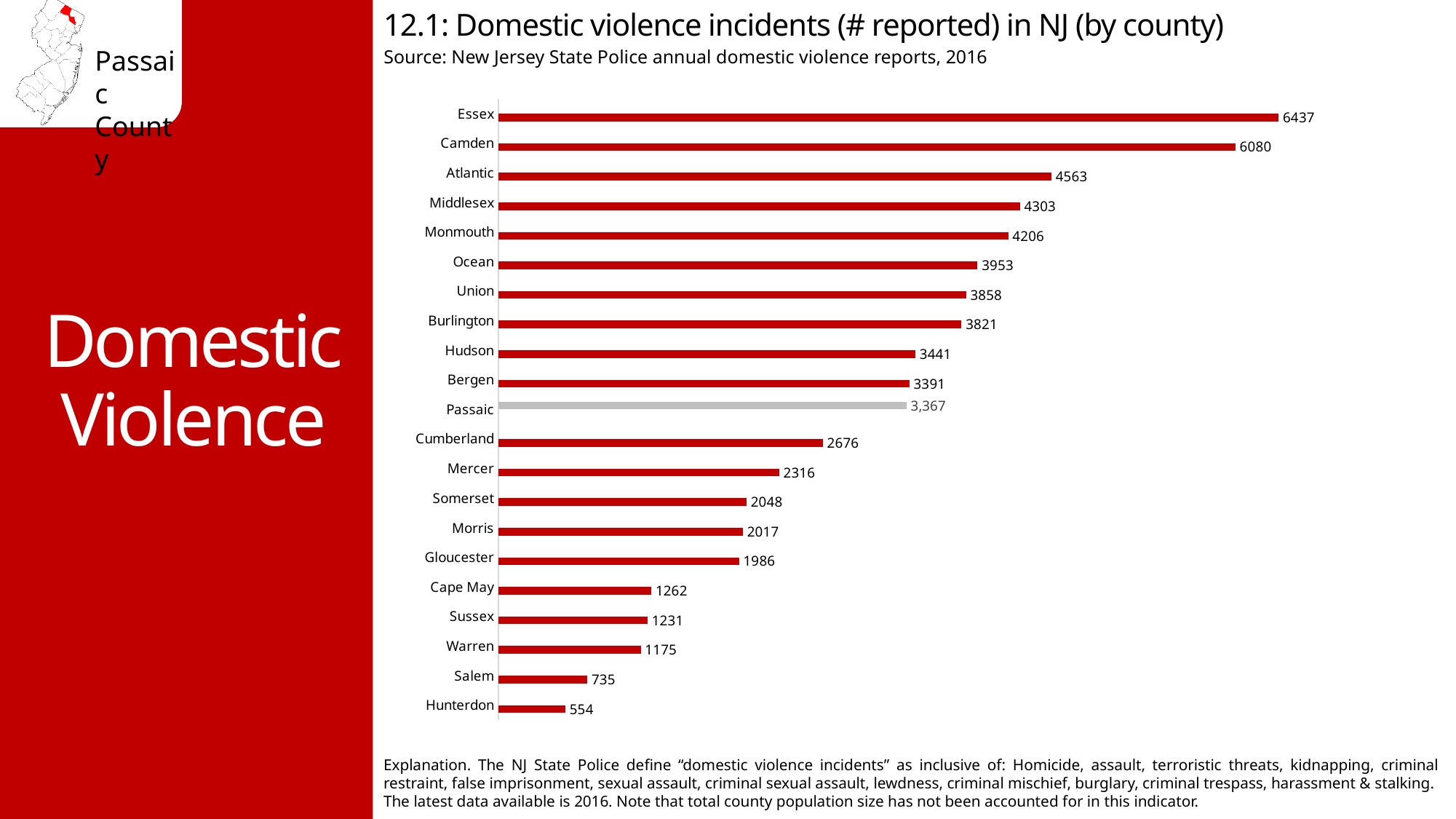
What is the difference between the values for Bergen and Passaic? 24 How many counties are shown in the chart? 21 What is the difference between the values for Essex and Camden? 357 Which county has more reported incidents, Ocean or Union? Ocean How many domestic violence incidents were reported in Essex county? 6437 What kind of chart is used on this slide? Bar chart What value is shown for Hunterdon county? 554 Which county has more reported incidents, Salem or Warren? Warren What is the number of domestic violence incidents reported for Passaic county? 3,367 Which county has the highest number of reported domestic violence incidents? Essex Which county's bar is shown in grey rather than red? Passaic Which county has the lowest number of reported domestic violence incidents? Hunterdon